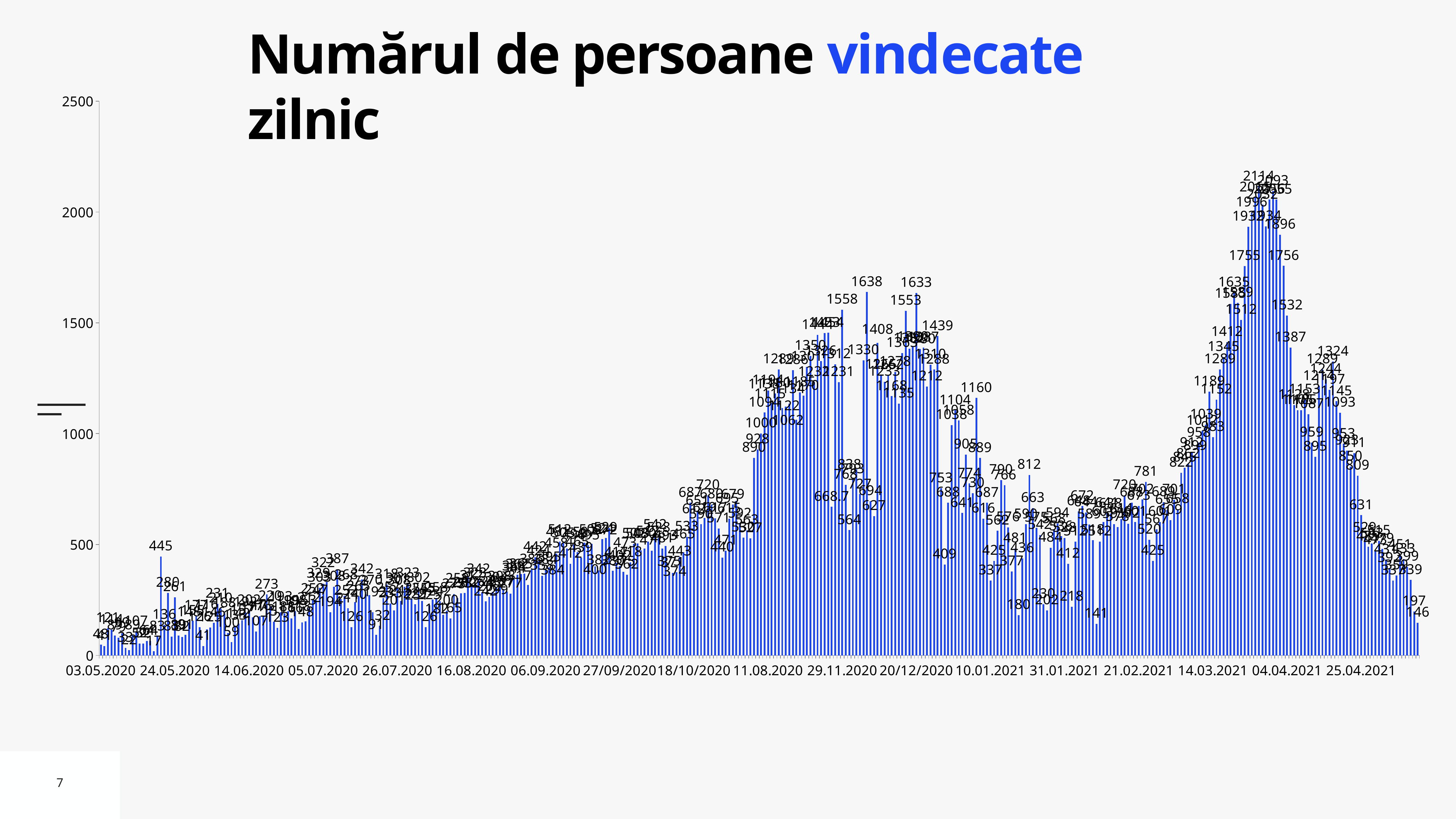
What is the highest value labeled on the chart? 2114 Which is larger, the peak value around 04.04.2021 or the peak value labeled 1638 around 29.11.2020? the peak around 04.04.2021 (2114) What kind of chart is shown on the slide? bar chart Is the highest bar on the chart greater or less than 2000? greater What is the value of the tallest bar between 10.01.2021 and 31.01.2021? 812 What is the difference between the peak value 2114 and the value 1638 labeled near 29.11.2020? 476 Do the values rise or fall between 14.03.2021 and 04.04.2021? rise What is the value of the last bar on the right of the chart? 146 Is the value of the last bar on the right greater or less than 500? less What colour are the bars in the chart? blue What is the title of the chart? Numărul de persoane vindecate zilnic What is the value of the isolated tall bar shortly after 24.05.2020? 445